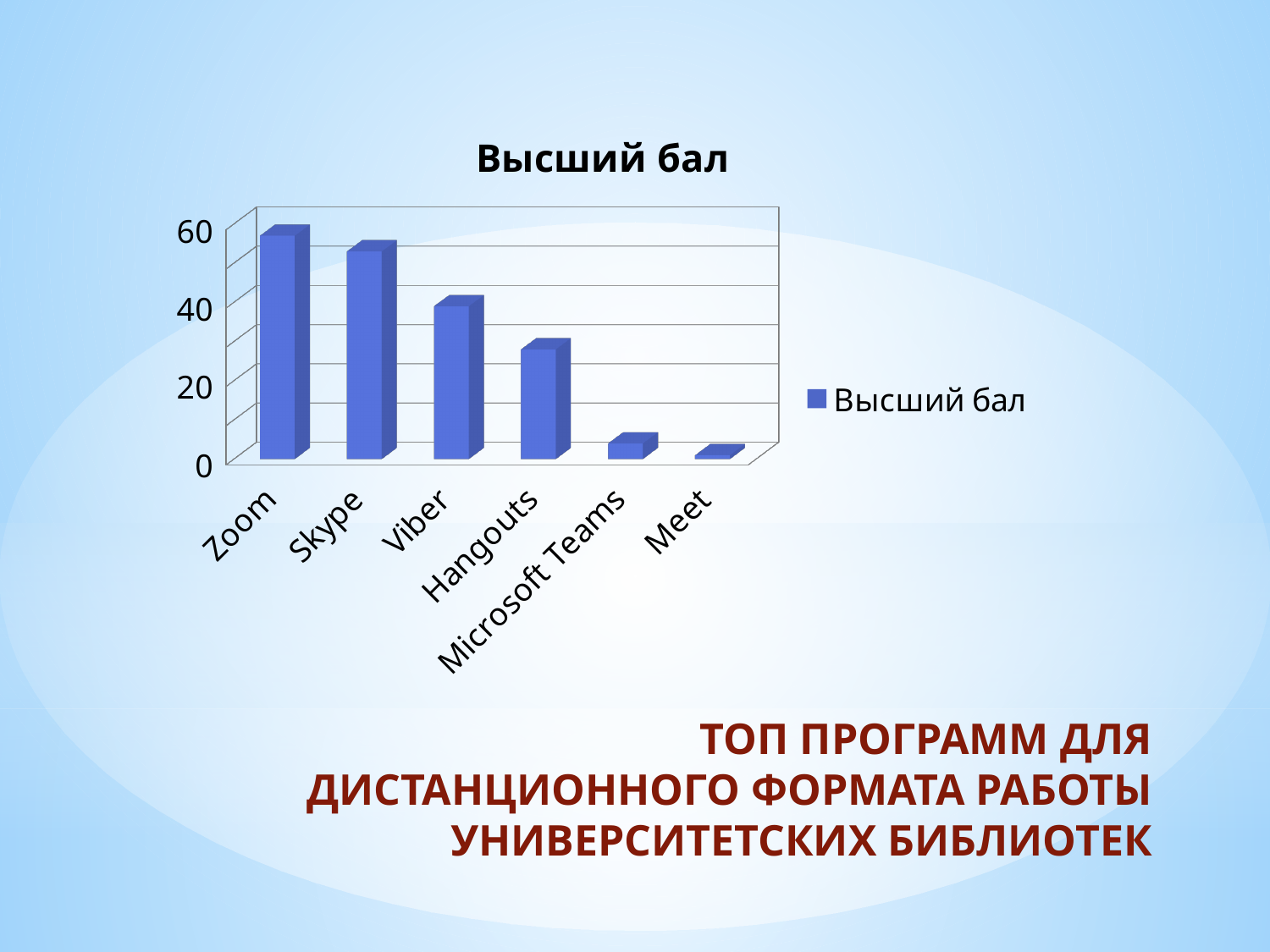
Is the value for Hangouts greater or less than 40? less Is the value for Microsoft Teams greater or less than 20? less How many categories are shown on the x axis of the chart? 6 Do the values rise or fall from left to right along the x axis? fall Which has a larger value, Viber or Hangouts? Viber Which category has the lowest value? Meet Which category has the highest value? Zoom What is the title of the chart? Высший бал What kind of chart is shown on the slide? bar chart Is the value for Zoom greater or less than 40? greater Which has a larger value, Microsoft Teams or Skype? Skype How many series does the legend list? 1